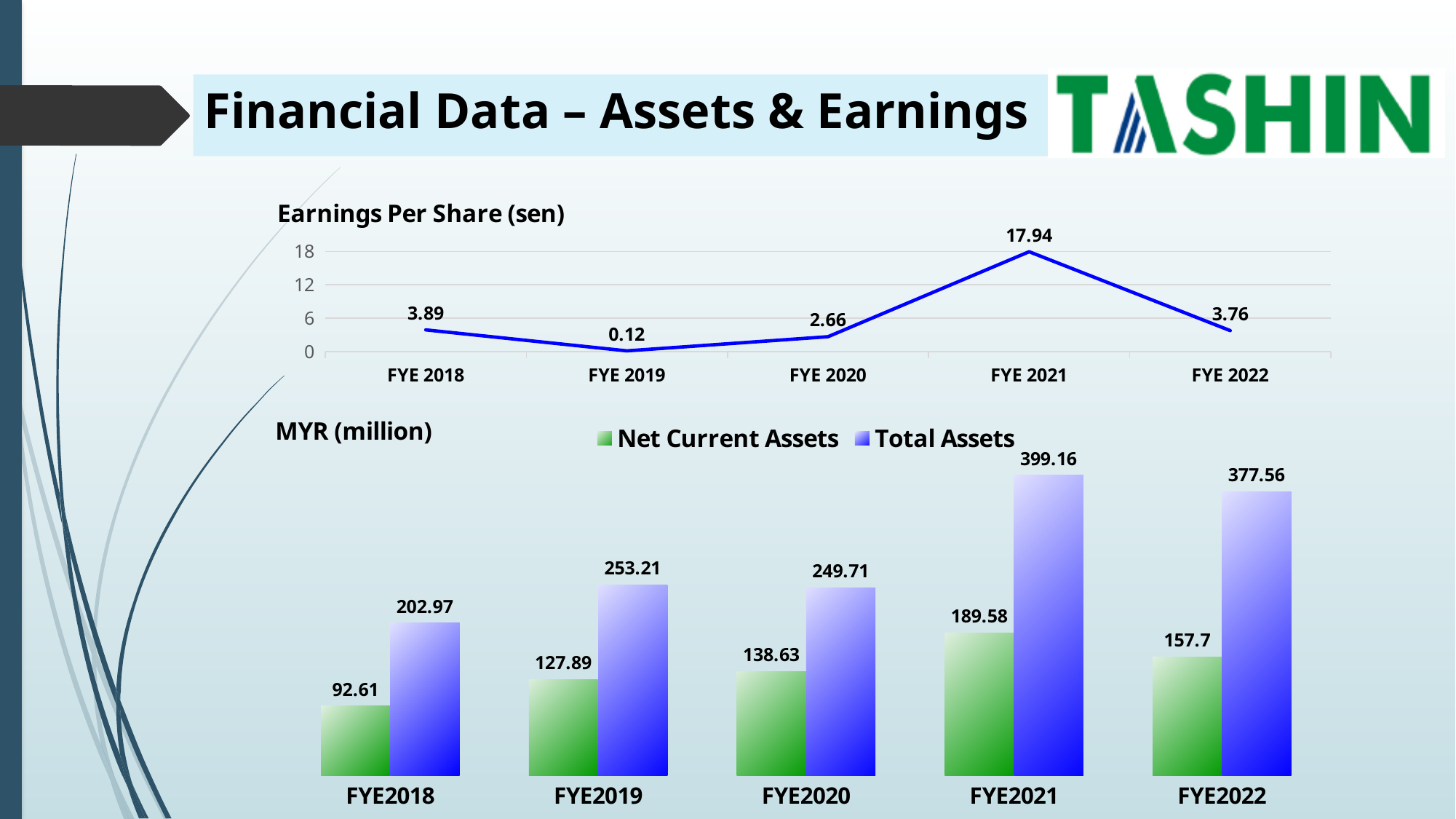
In the Earnings Per Share (sen) chart, does the value rise or fall from FYE 2018 to FYE 2019? Fall In the MYR (million) bar chart, what is the Total Assets value for FYE2021? 399.16 In the Earnings Per Share (sen) chart, which year has the lowest earnings per share? FYE 2019 In the MYR (million) bar chart, which is larger: Total Assets for FYE2019 or Total Assets for FYE2020? FYE2019 In the MYR (million) bar chart, which year has the highest Net Current Assets? FYE2021 In the Earnings Per Share (sen) chart, how many years are plotted? 5 In the MYR (million) bar chart, what is the difference between Total Assets and Net Current Assets for FYE2022? 219.86 In the Earnings Per Share (sen) chart, what is the difference between the FYE 2021 and FYE 2022 values? 14.18 What kind of chart is the Earnings Per Share (sen) chart? Line chart How many series does the legend of the MYR (million) bar chart list? 2 In the Earnings Per Share (sen) chart, what is the value for FYE 2021? 17.94 In the MYR (million) bar chart, what is the Net Current Assets value for FYE2018? 92.61